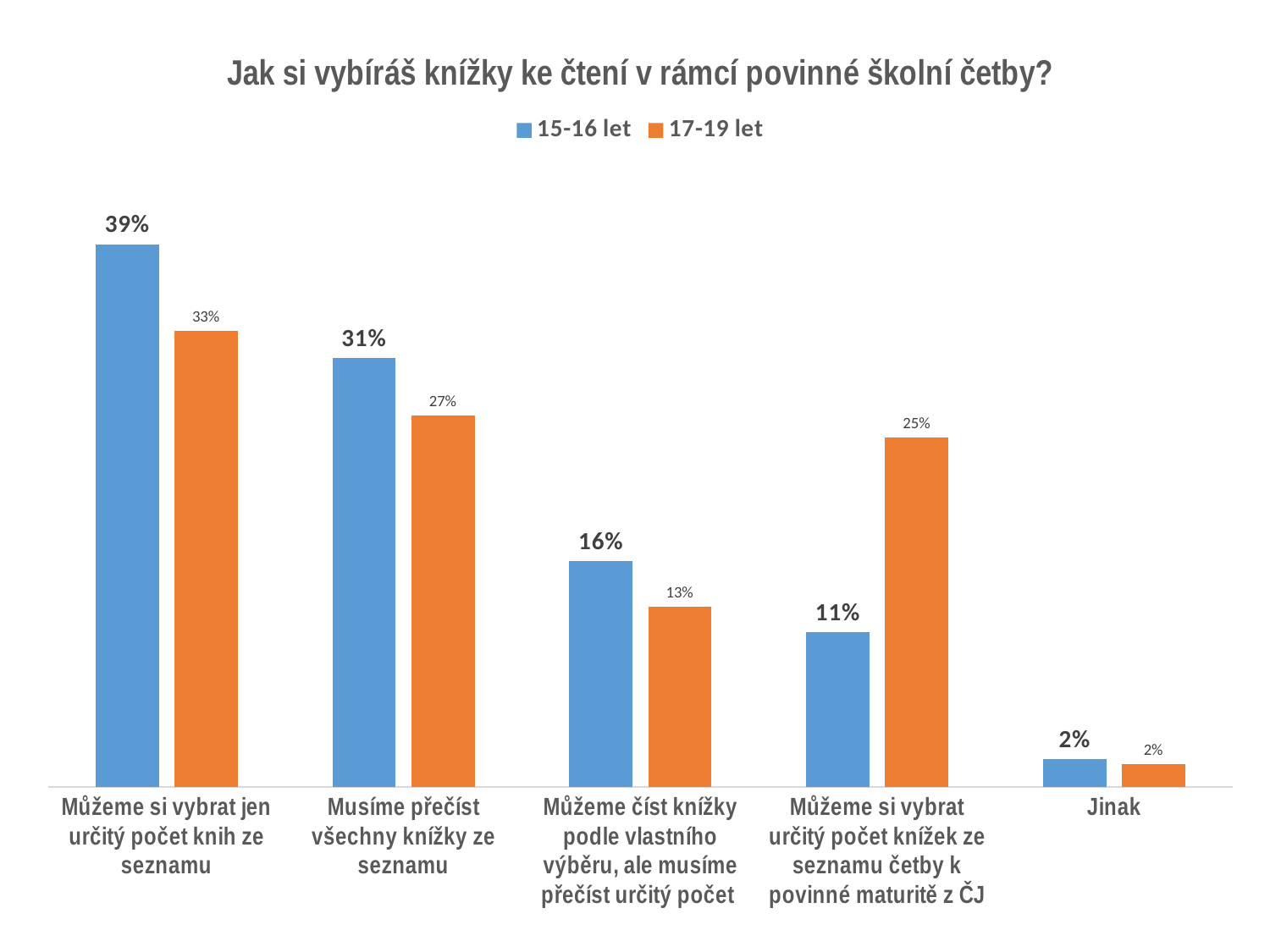
How many categories are shown on the x axis? 5 What is the value for 15-16 let in the category 'Můžeme si vybrat jen určitý počet knih ze seznamu'? 39% What is the difference between the 15-16 let and 17-19 let values in the category 'Můžeme si vybrat určitý počet knížek ze seznamu četby k povinné maturitě z ČJ'? 14% What is the title of the chart? Jak si vybíráš knížky ke čtení v rámcí povinné školní četby? What is the value for 17-19 let in the category 'Musíme přečíst všechny knížky ze seznamu'? 27% Which category has the highest value for the 15-16 let series? Můžeme si vybrat jen určitý počet knih ze seznamu What kind of chart is shown on the slide? Bar chart What is the difference between the 15-16 let and 17-19 let values in the category 'Můžeme si vybrat jen určitý počet knih ze seznamu'? 6% What is the value for 17-19 let in the category 'Můžeme si vybrat určitý počet knížek ze seznamu četby k povinné maturitě z ČJ'? 25% How many series does the legend list? 2 In the category 'Můžeme číst knížky podle vlastního výběru, ale musíme přečíst určitý počet', which series has the larger value, 15-16 let or 17-19 let? 15-16 let Which category has the lowest value for the 17-19 let series? Jinak